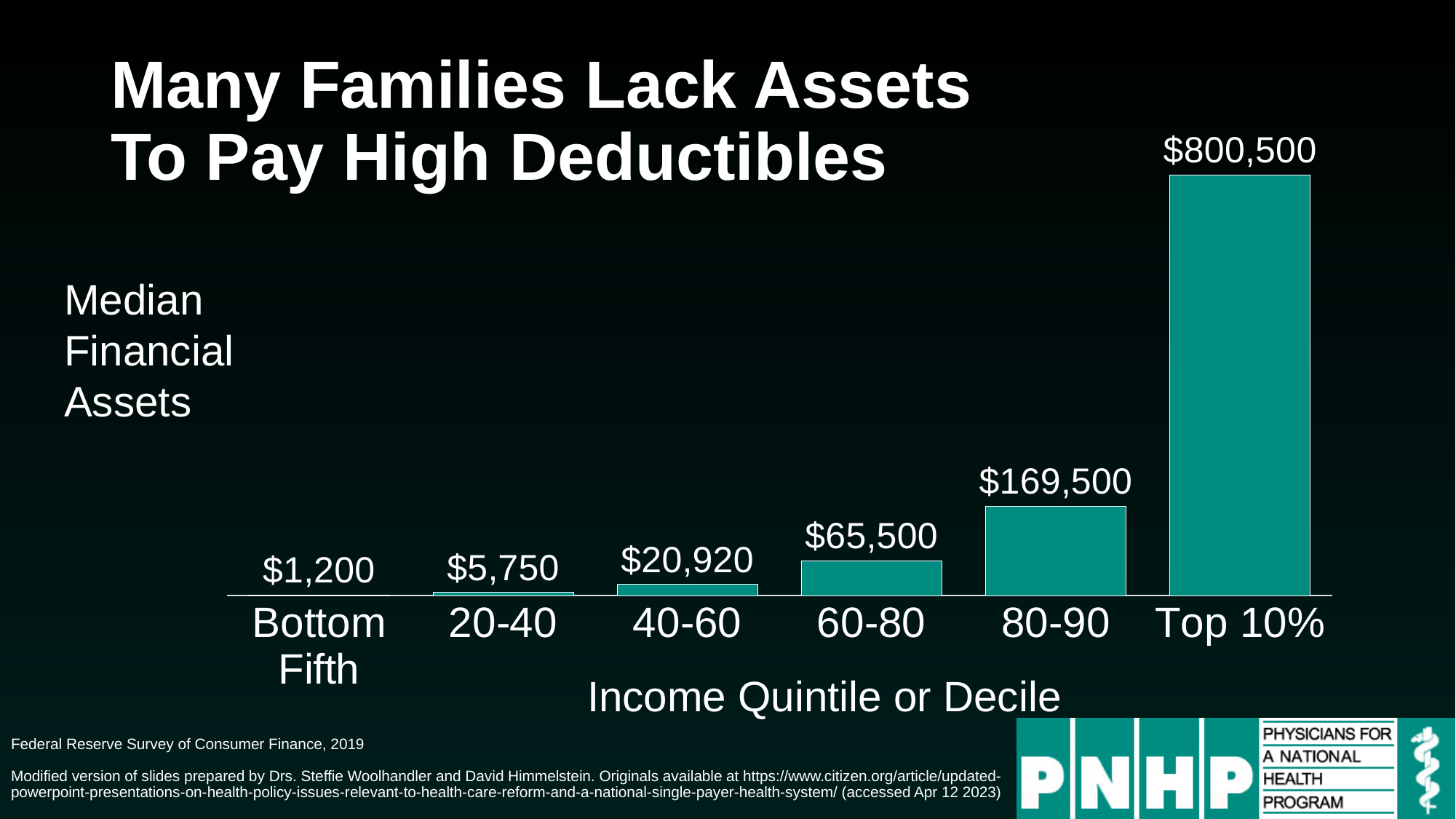
Which has higher median financial assets, the 20-40 group or the 60-80 group? 60-80 Which income group has the lowest median financial assets? Bottom Fifth What is the median financial assets value for the 40-60 income group? $20,920 What is the difference in median financial assets between the Top 10% and the 80-90 income groups? $631,000 How many income groups are shown in the chart? 6 Do median financial assets rise or fall as income group increases along the x axis? Rise What is the median financial assets value for the 80-90 income group? $169,500 What is the median financial assets value for the Bottom Fifth income group? $1,200 What kind of chart is shown on the slide? Bar chart What is the median financial assets value for the Top 10% income group? $800,500 Which income group has the highest median financial assets? Top 10% What is the difference in median financial assets between the 60-80 and 40-60 income groups? $44,580